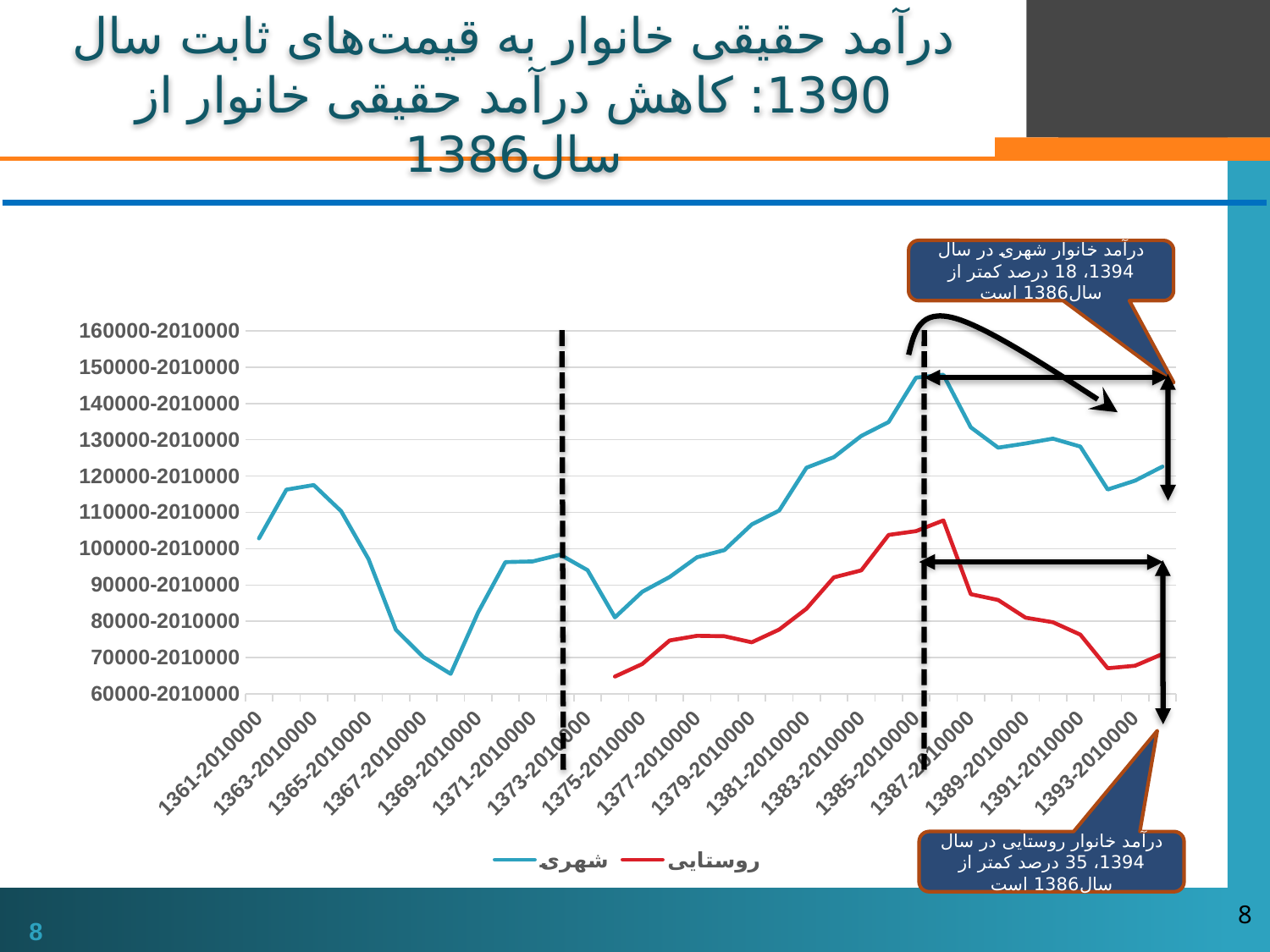
Is the peak of the روستایی line (around 1387) greater or less than the 100000-2010000 axis tick? greater Does the روستایی line generally rise or fall between 1375-2010000 and 1387-2010000? rise How many year labels are shown along the x axis of the chart? 17 What are the two series named in the chart legend? شهری and روستایی How many series does the chart legend list? 2 Is the شهری value at 1369-2010000 greater or less than the 70000-2010000 axis tick? greater According to the callout on the chart, by what percentage is rural household income in 1394 lower than in 1386? 35 درصد What kind of chart is shown on the slide? line chart Which series, شهری or روستایی, has the higher value at 1385-2010000? شهری Does the شهری line rise or fall between 1386-2010000 and 1391-2010000? fall Is the peak of the شهری line (around 1386) greater or less than the 140000-2010000 axis tick? greater